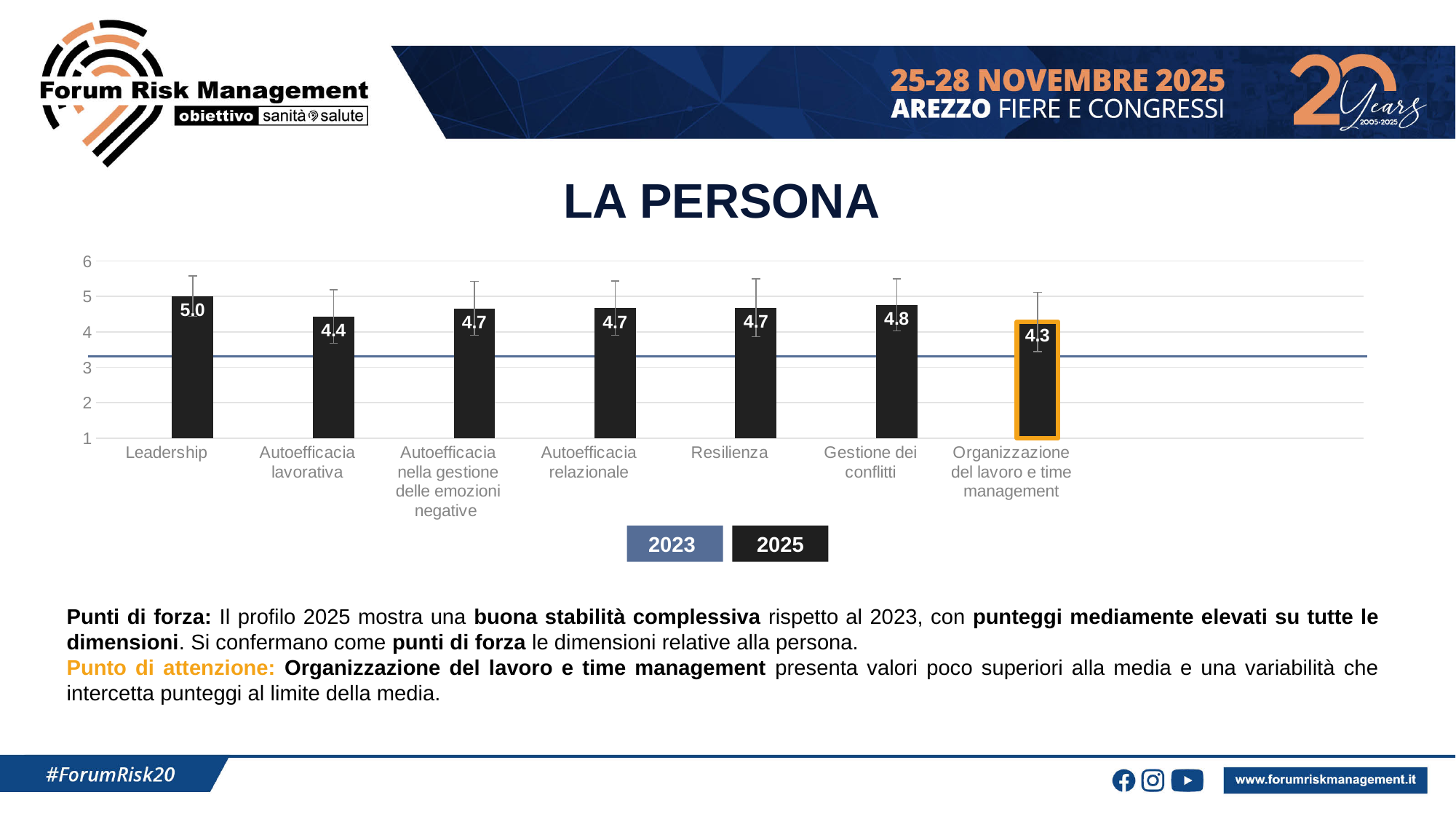
What is the title of the chart? LA PERSONA How many series does the legend list? 2 Which is larger, the value for Gestione dei conflitti or the value for Autoefficacia lavorativa? Gestione dei conflitti Which category has the highest value? Leadership What is the difference between the values for Leadership and Organizzazione del lavoro e time management? 0.7 What is the value shown for Organizzazione del lavoro e time management? 4.3 Which category has the lowest value? Organizzazione del lavoro e time management How many categories are shown on the x axis? 7 What is the value shown for Leadership? 5.0 What kind of chart is shown on the slide? Bar chart What is the value shown for Gestione dei conflitti? 4.8 What is the value shown for Autoefficacia lavorativa? 4.4